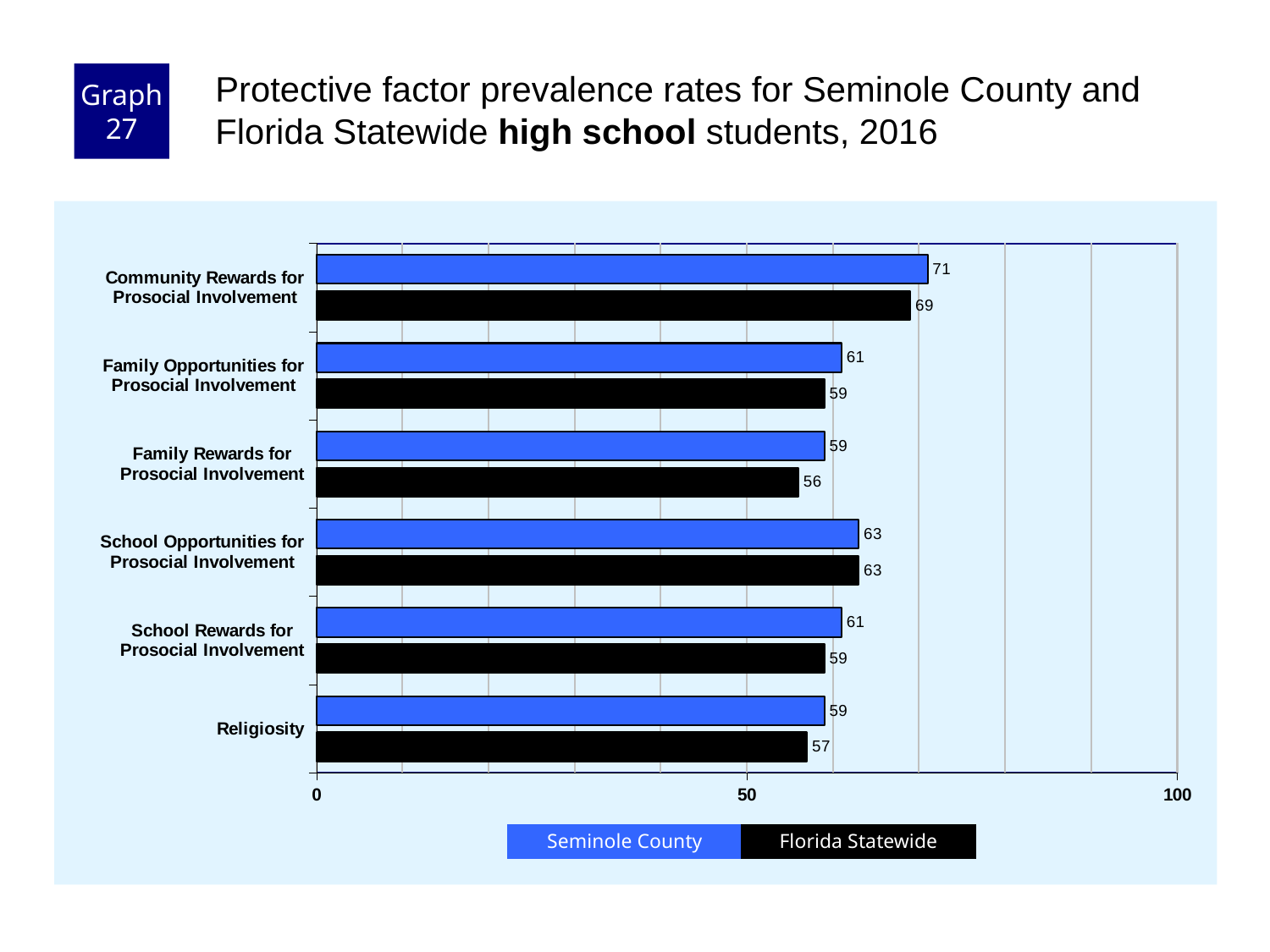
Which category has the lowest Florida Statewide value? Family Rewards for Prosocial Involvement What is the difference between the Seminole County and Florida Statewide values for Family Rewards for Prosocial Involvement? 3 Is the Seminole County value for School Opportunities for Prosocial Involvement greater or less than 50? greater How many series does the legend list? 2 Which colour represents Florida Statewide in the chart? black What kind of chart is shown on the slide? bar chart What is the Seminole County value for Community Rewards for Prosocial Involvement? 71 How many protective factor categories are shown on the chart? 6 Which is larger for Religiosity, the Seminole County value or the Florida Statewide value? Seminole County Which category has the highest Seminole County value? Community Rewards for Prosocial Involvement What is the Florida Statewide value for Religiosity? 57 What is the Florida Statewide value for Family Rewards for Prosocial Involvement? 56